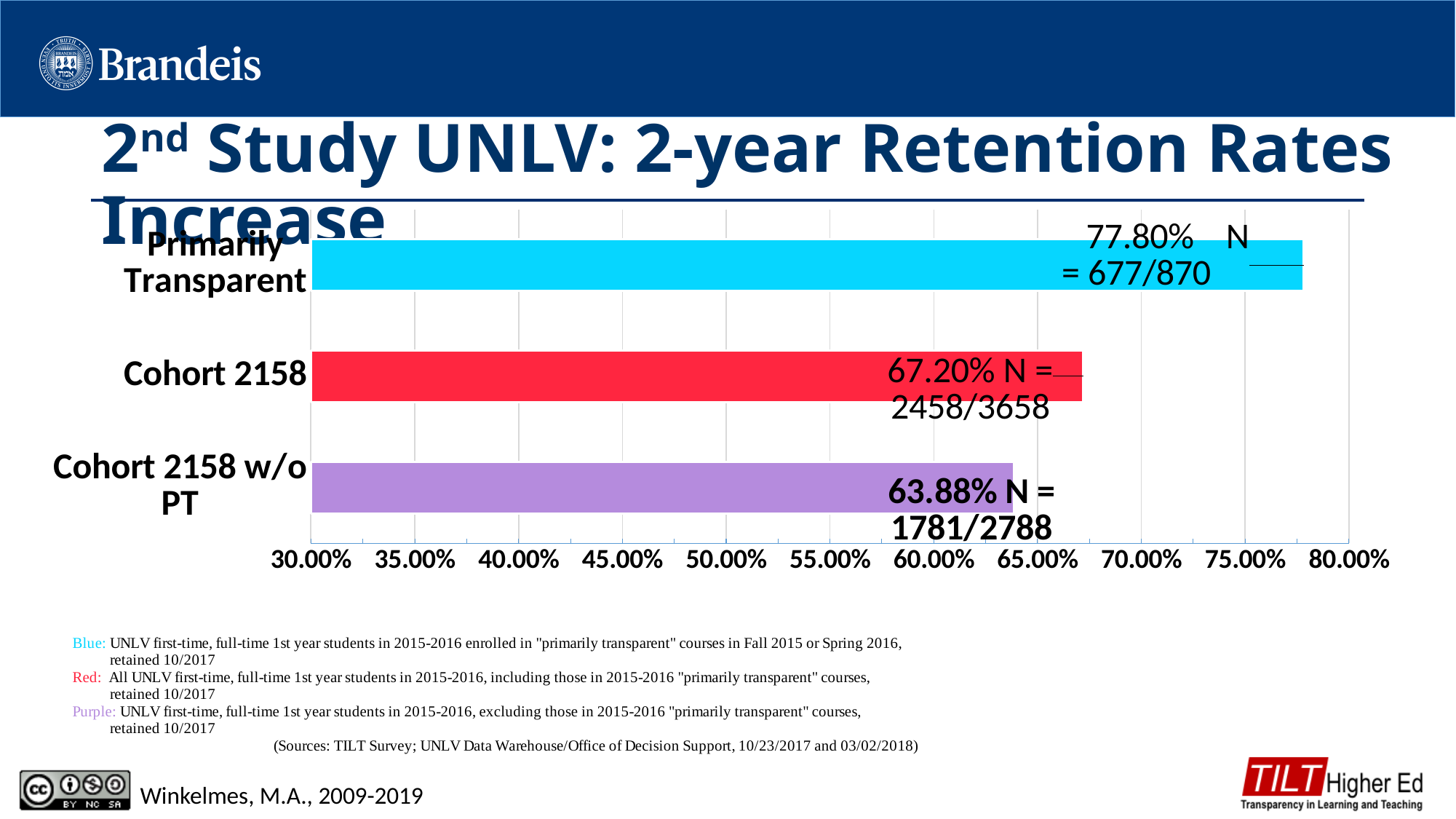
What is the 2-year retention rate for Cohort 2158 w/o PT? 63.88% What is the 2-year retention rate for Cohort 2158? 67.20% Is the retention rate for Primarily Transparent greater or less than 75.00%? greater Which has a higher retention rate, Cohort 2158 or Cohort 2158 w/o PT? Cohort 2158 What is the difference in retention rate between Cohort 2158 and Cohort 2158 w/o PT? 3.32% Which category has the highest retention rate? Primarily Transparent What is the 2-year retention rate for Primarily Transparent? 77.80% How many categories are shown in the chart? 3 What kind of chart is shown on the slide? bar chart Which category has the lowest retention rate? Cohort 2158 w/o PT What is the N value shown for the Primarily Transparent bar? 677/870 What is the difference in retention rate between Primarily Transparent and Cohort 2158? 10.60%